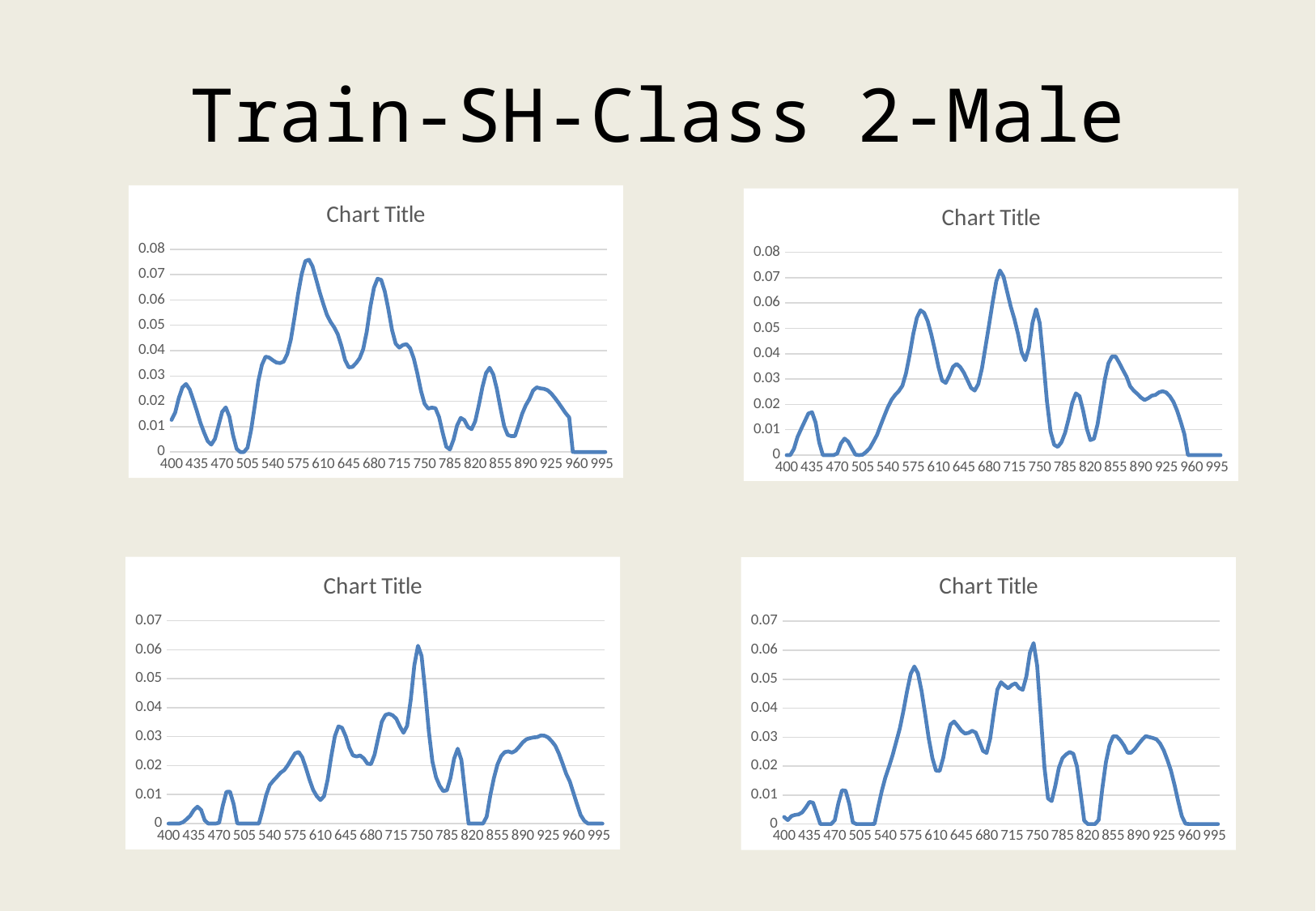
In the top-left chart, how many labelled points are there along the x axis? 18 What kind of chart is the top-left chart? line chart In the bottom-right chart, is the value at 575 greater or less than 0.04? greater In the top-right chart, do the values rise or fall from 540 to 575? rise In the top-left chart, is the value at 680 greater or less than 0.06? greater In the top-right chart, is the value at 995 greater or less than 0.01? less How many charts are shown on the slide? 4 In the top-left chart, do the values rise or fall from 925 to 995? fall What is the title shown on the top-right chart? Chart Title